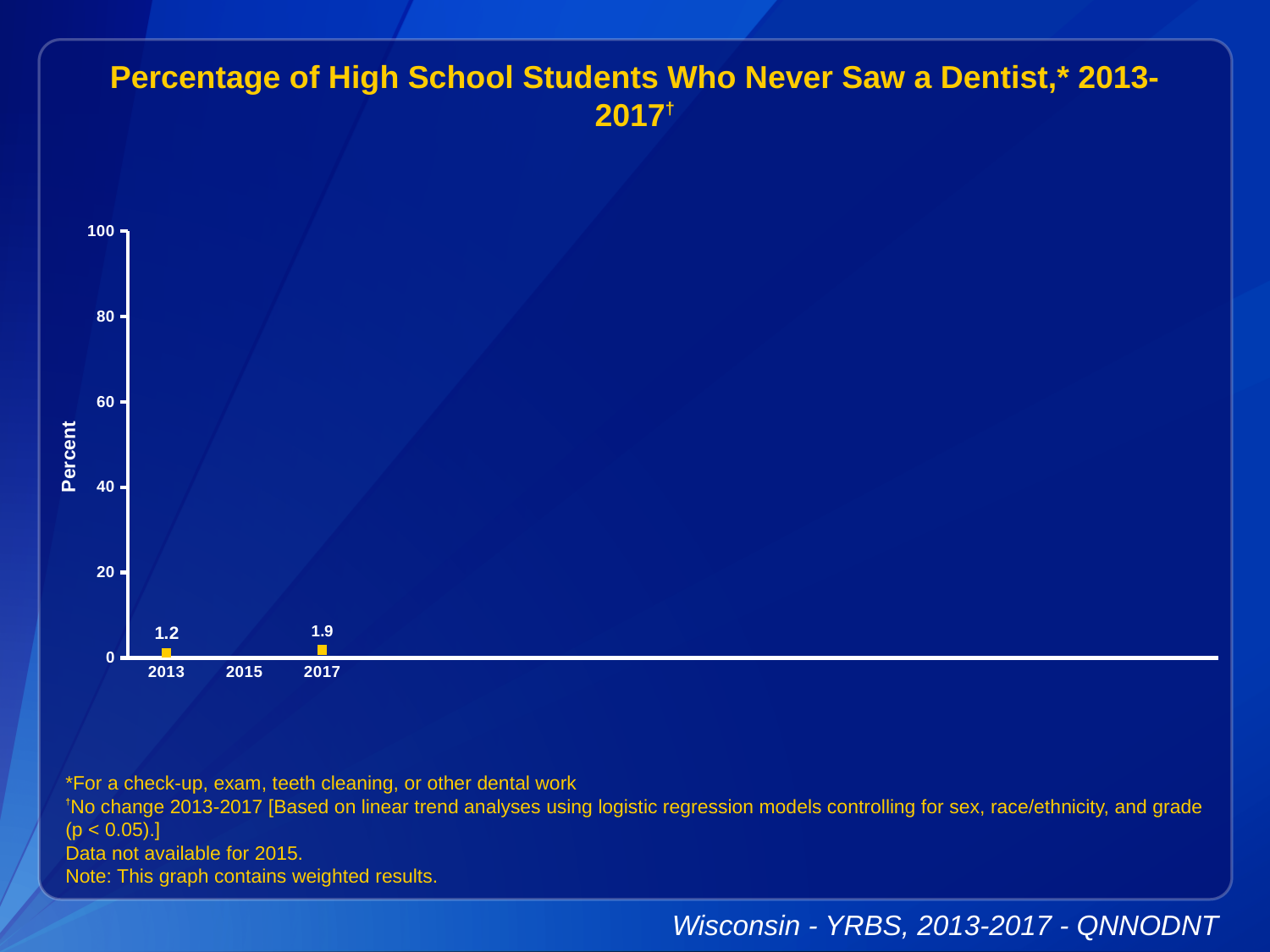
How many years are labeled on the x axis? 3 Which year with a plotted value has the lowest value? 2013 What kind of chart is shown? line chart What is the difference between the values for 2017 and 2013? 0.7 What is the value for 2013? 1.2 Which is larger, the value for 2013 or the value for 2017? 2017 What is the label on the y axis? Percent Which year has the highest value? 2017 What is the value for 2017? 1.9 For which year is data not available? 2015 Do the plotted values rise or fall from 2013 to 2017? rise Is the value for 2017 greater or less than 20? less